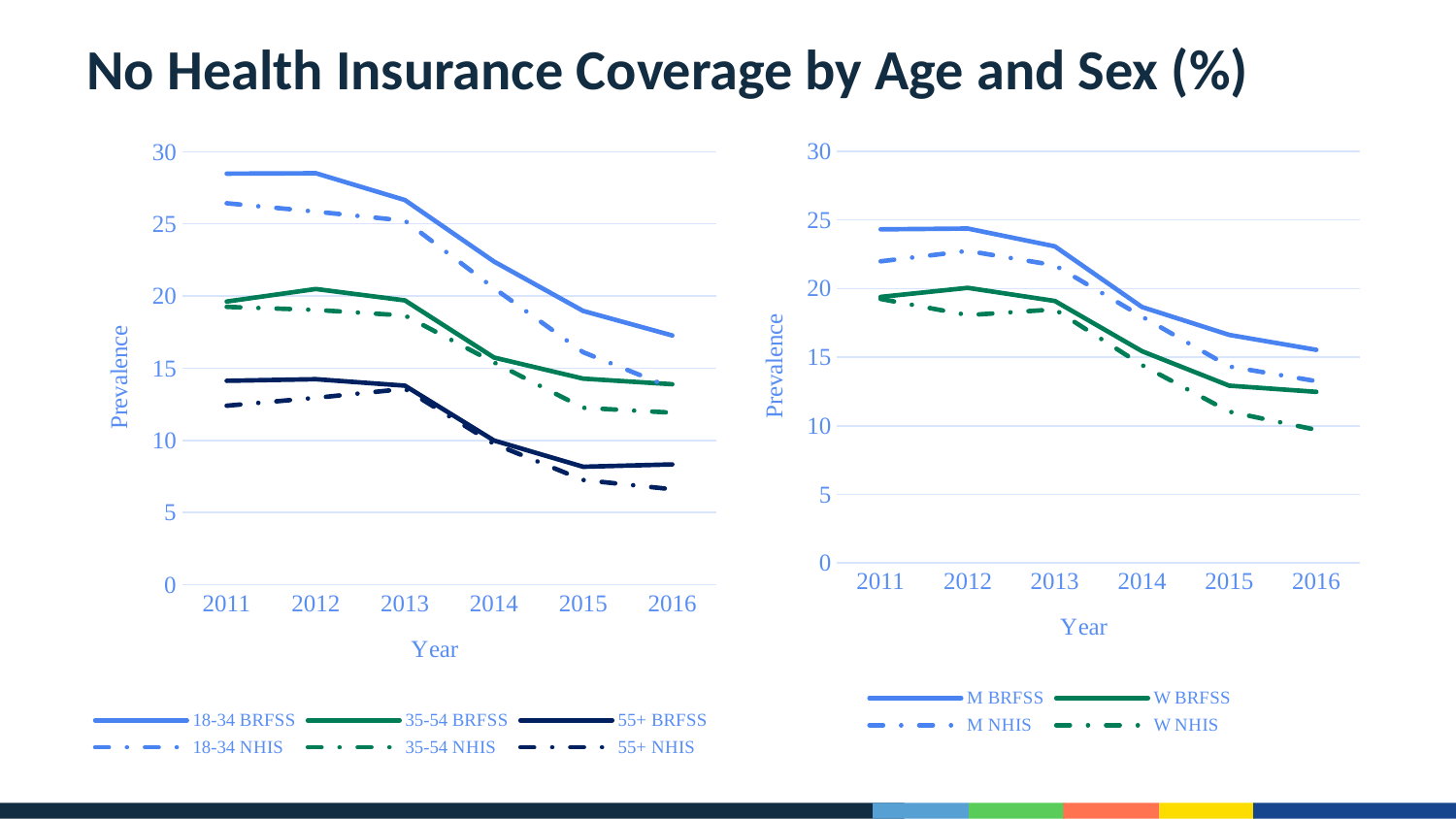
In the left chart, which series has the lowest value in 2016? 55+ NHIS In the right chart, does the M BRFSS series rise or fall from 2013 to 2016? fall How many series does the legend of the left chart list? 6 In the left chart, is the value for 18-34 BRFSS in 2011 greater or less than 25? greater In the left chart, is the value for 55+ BRFSS in 2016 greater or less than 10? less In the left chart, which series has the highest value in 2011? 18-34 BRFSS In the right chart, which series has the lowest value in 2016? W NHIS How many series does the legend of the right chart list? 4 In the right chart, is the value for M BRFSS in 2013 greater or less than 20? greater What type of chart is the left chart on the slide? Line chart How many years are shown on the x axis of the right chart? 6 In the right chart, which is larger in 2011, M BRFSS or W BRFSS? M BRFSS